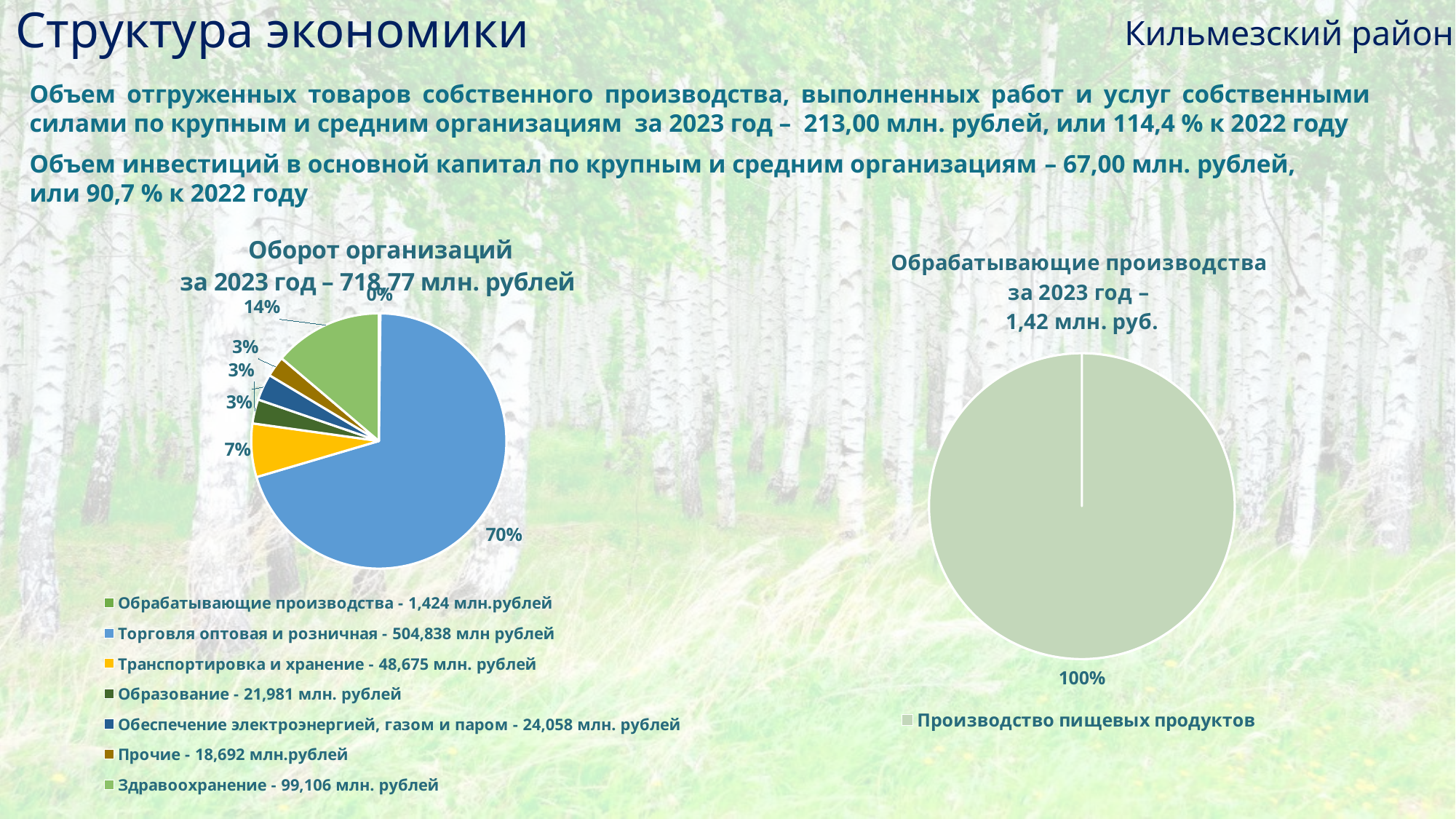
What total value is stated in the title of the 'Обрабатывающие производства за 2023 год' chart on the right? 1,42 млн. руб. In the 'Оборот организаций за 2023 год' pie chart, what share does 'Транспортировка и хранение' hold? 7% According to the legend of the 'Оборот организаций за 2023 год' chart, what is the value for 'Обеспечение электроэнергией, газом и паром'? 24,058 млн. рублей In the 'Оборот организаций за 2023 год' pie chart, what share does 'Торговля оптовая и розничная' hold? 70% What type of chart is the 'Оборот организаций за 2023 год' chart on the left? pie chart In the 'Оборот организаций за 2023 год' pie chart, which category has the smallest slice? Обрабатывающие производства In the 'Обрабатывающие производства за 2023 год' pie chart on the right, what share does 'Производство пищевых продуктов' hold? 100% According to the legend of the 'Оборот организаций за 2023 год' chart, what is the value for 'Образование'? 21,981 млн. рублей How many categories does the legend of the 'Оборот организаций за 2023 год' pie chart list? 7 In the 'Оборот организаций за 2023 год' pie chart, which is larger: the share of 'Здравоохранение' or the share of 'Транспортировка и хранение'? Здравоохранение In the 'Оборот организаций за 2023 год' pie chart, which category has the largest slice? Торговля оптовая и розничная